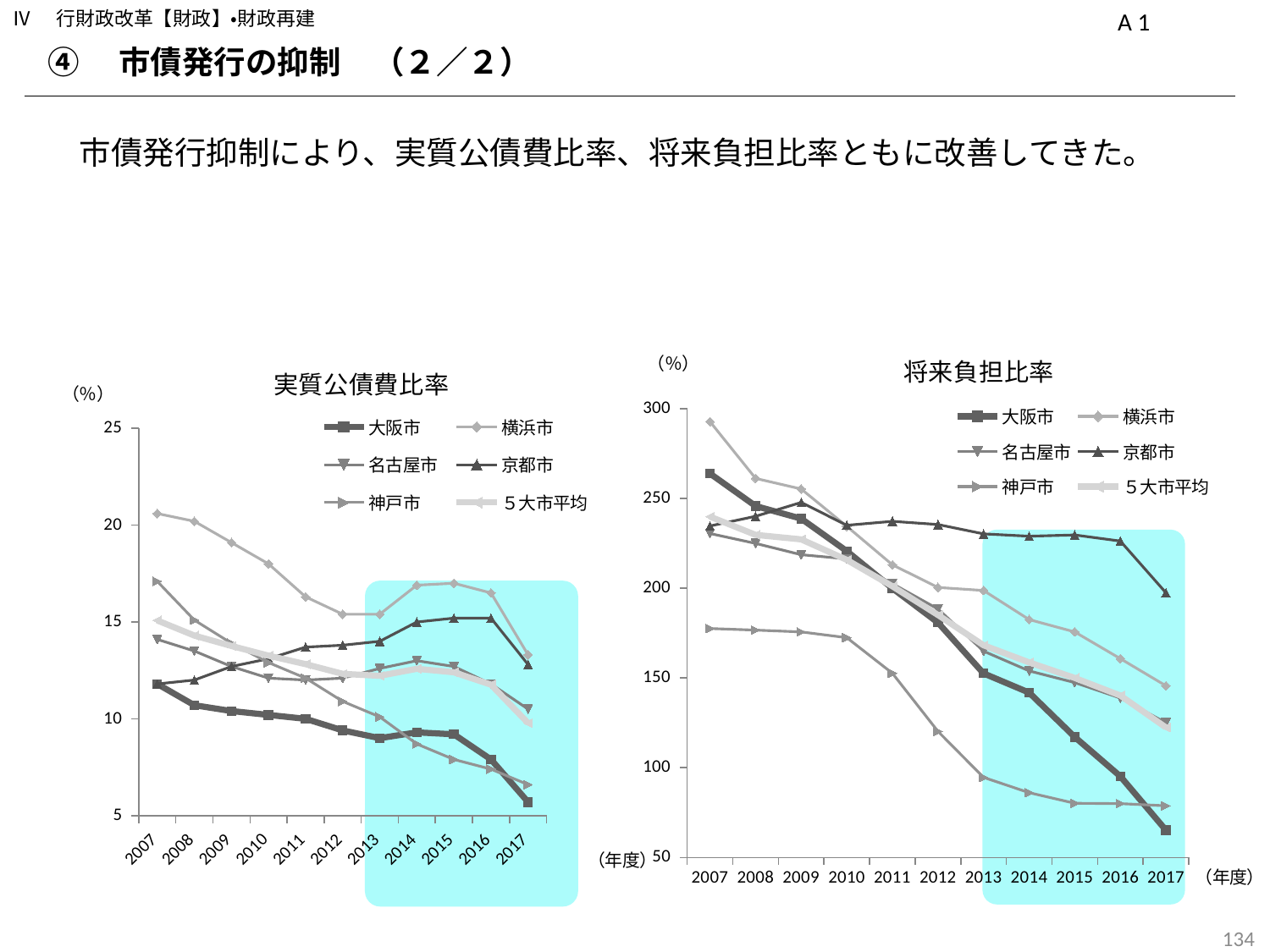
In the 将来負担比率 chart, which city has the lowest value in 2007? 神戸市 How many years are plotted along the x axis of the 実質公債費比率 chart? 11 What kind of chart is the 実質公債費比率 chart on the left? line chart In the 実質公債費比率 chart, is the value for 横浜市 in 2007 greater or less than 20? greater In the 将来負担比率 chart, which is larger in 2017, 京都市 or 横浜市? 京都市 In the 将来負担比率 chart, is the value for 横浜市 in 2007 greater or less than 250? greater In the 実質公債費比率 chart, does the 大阪市 line rise or fall from 2007 to 2017? fall In the 実質公債費比率 chart, is the value for 大阪市 in 2017 greater or less than 10? less How many series does the legend of the 将来負担比率 chart list? 6 In the 将来負担比率 chart, which city has the highest value in 2017? 京都市 In the 実質公債費比率 chart, which city has the highest value in 2007? 横浜市 What is the title of the chart on the right of the slide? 将来負担比率